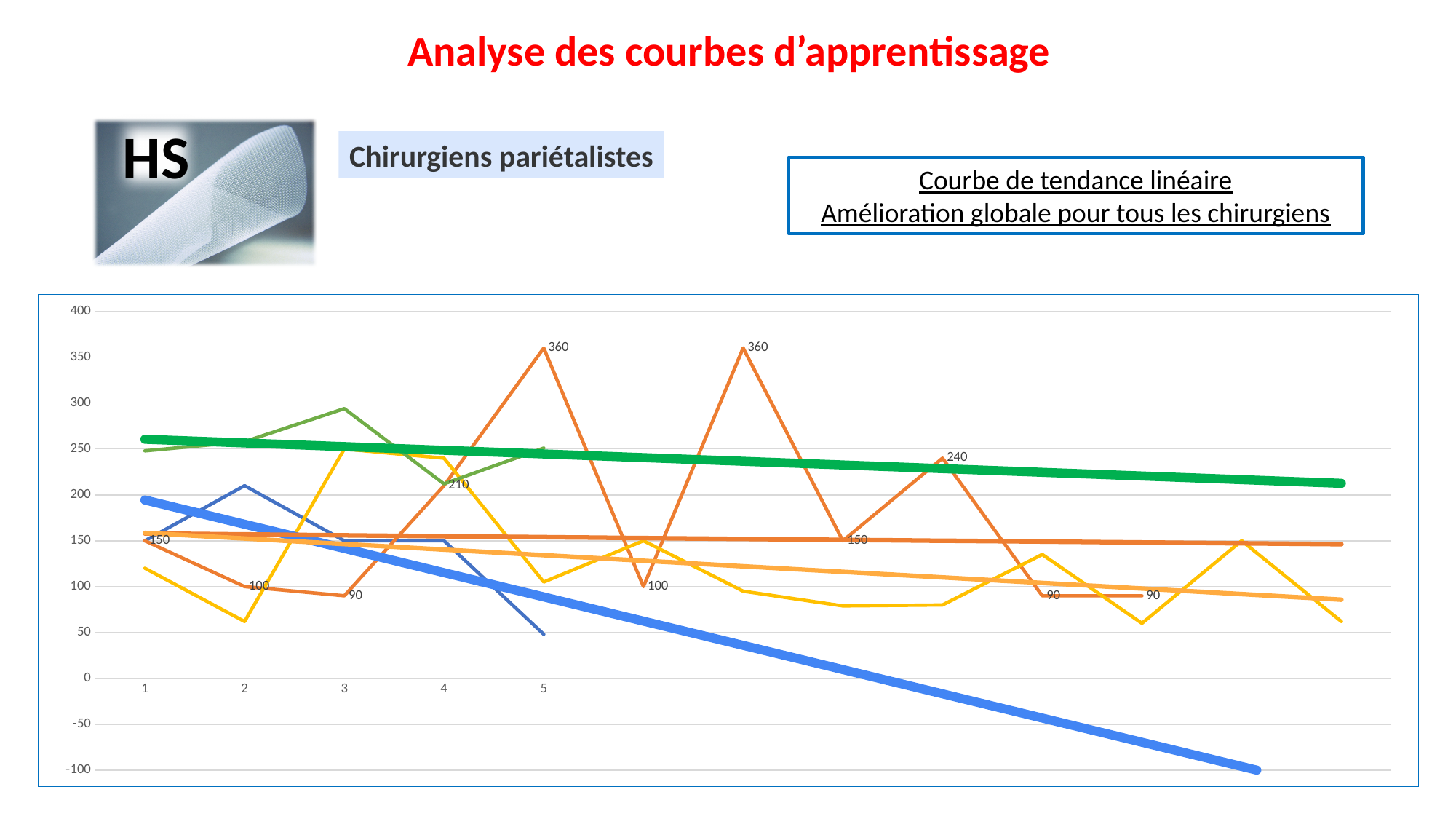
How many numbered categories are labelled on the x axis? 5 What is the data label on the orange line at x = 3? 90 What is the highest value shown on the y axis? 400 What is the lowest labelled value on the orange line? 90 What is the data label on the orange line at x = 5? 360 What is the data label on the orange line at x = 1? 150 What is the difference between the orange line's labelled values at x = 5 (360) and x = 4 (210)? 150 Is the value of the yellow line at x = 2 greater or less than 100? less What is the highest labelled value on the orange line? 360 Does the thick blue trend line rise or fall from left to right? fall Is the value of the green line at x = 3 greater or less than 250? greater What type of chart is shown on the slide? line chart